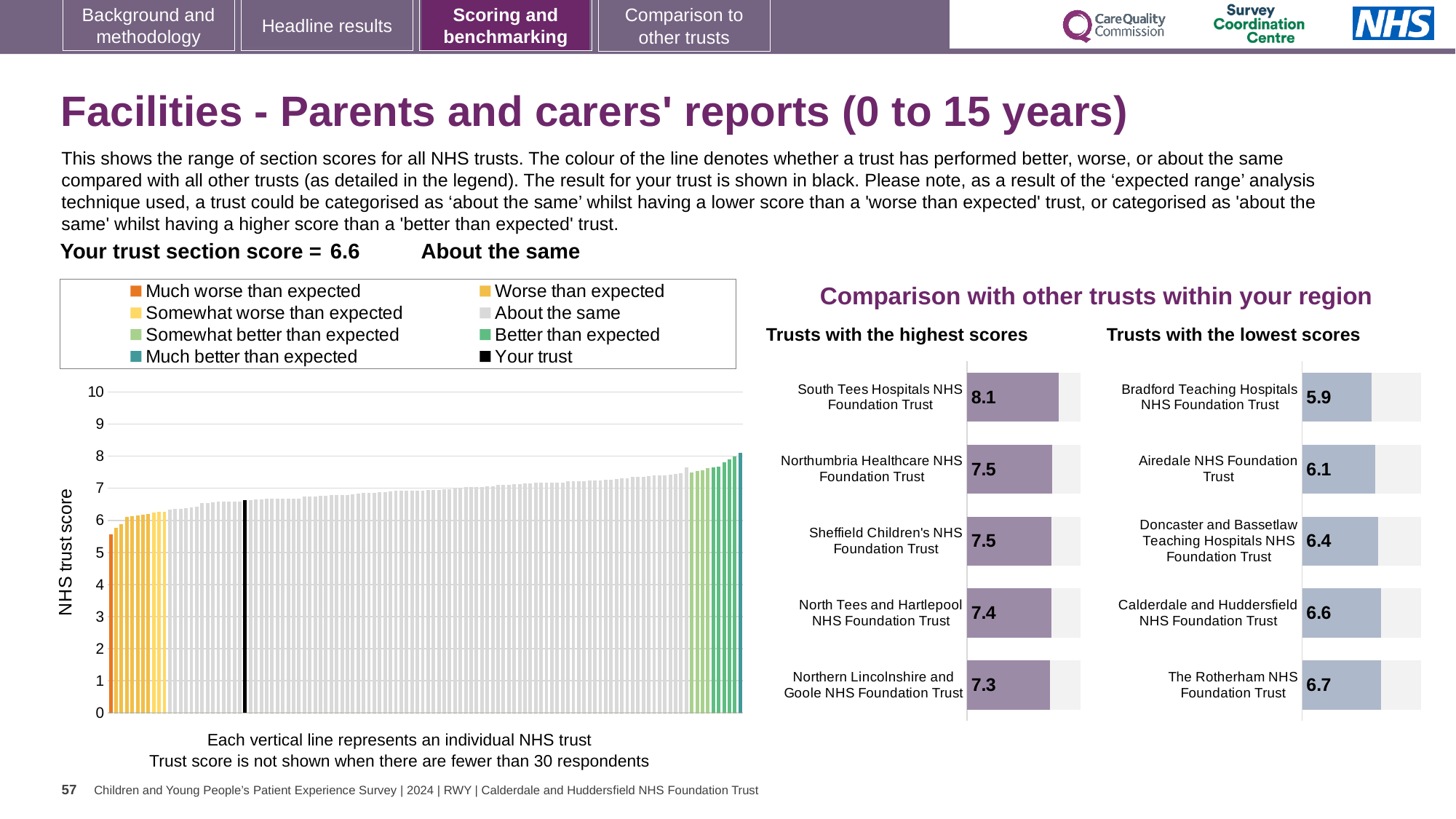
In the 'Trusts with the lowest scores' chart, what is the score for Calderdale and Huddersfield NHS Foundation Trust? 6.6 In the main chart on the left showing the range of section scores for all NHS trusts, how many entries does the legend list? 8 In the main chart on the left showing the range of section scores for all NHS trusts, is the value of the lowest (orange) bar greater or less than 6? less In the 'Trusts with the highest scores' chart, what is the difference between the scores of South Tees Hospitals NHS Foundation Trust and Northern Lincolnshire and Goole NHS Foundation Trust? 0.8 In the 'Trusts with the lowest scores' chart, which has the larger score: Airedale NHS Foundation Trust or Doncaster and Bassetlaw Teaching Hospitals NHS Foundation Trust? Doncaster and Bassetlaw Teaching Hospitals NHS Foundation Trust In the 'Trusts with the lowest scores' chart, which trust has the highest score? The Rotherham NHS Foundation Trust In the 'Trusts with the highest scores' chart, which trust has the lowest score? Northern Lincolnshire and Goole NHS Foundation Trust In the 'Trusts with the lowest scores' chart, what is the difference between the scores of The Rotherham NHS Foundation Trust and Bradford Teaching Hospitals NHS Foundation Trust? 0.8 In the 'Trusts with the lowest scores' chart, what is the score for Bradford Teaching Hospitals NHS Foundation Trust? 5.9 In the main chart on the left showing the range of section scores for all NHS trusts, what kind of chart is it? Bar chart In the 'Trusts with the highest scores' chart, what is the score for South Tees Hospitals NHS Foundation Trust? 8.1 In the 'Trusts with the highest scores' chart, how many trusts are shown? 5